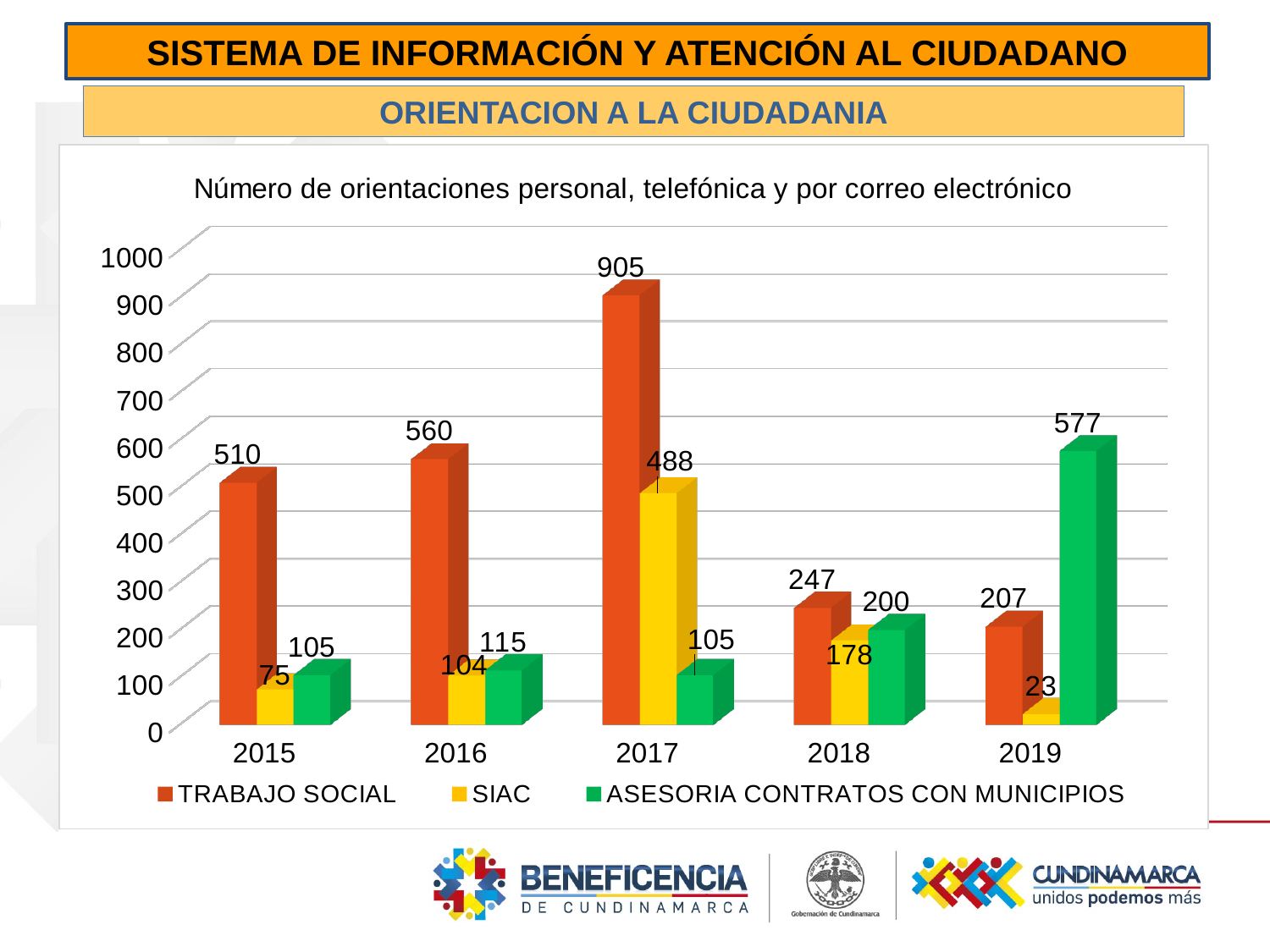
In which year is the SIAC value lowest? 2019 What is the title of the chart? Número de orientaciones personal, telefónica y por correo electrónico What is the value for SIAC in 2019? 23 What is the value for ASESORIA CONTRATOS CON MUNICIPIOS in 2018? 200 How many years are shown on the x axis? 5 What is the difference between the TRABAJO SOCIAL values for 2016 and 2015? 50 What is the value for TRABAJO SOCIAL in 2017? 905 What kind of chart is shown on the slide? Bar chart Does the TRABAJO SOCIAL value rise or fall from 2017 to 2019? Fall How many series does the legend list? 3 In which year is the TRABAJO SOCIAL value highest? 2017 Which is larger in 2019: TRABAJO SOCIAL or ASESORIA CONTRATOS CON MUNICIPIOS? ASESORIA CONTRATOS CON MUNICIPIOS